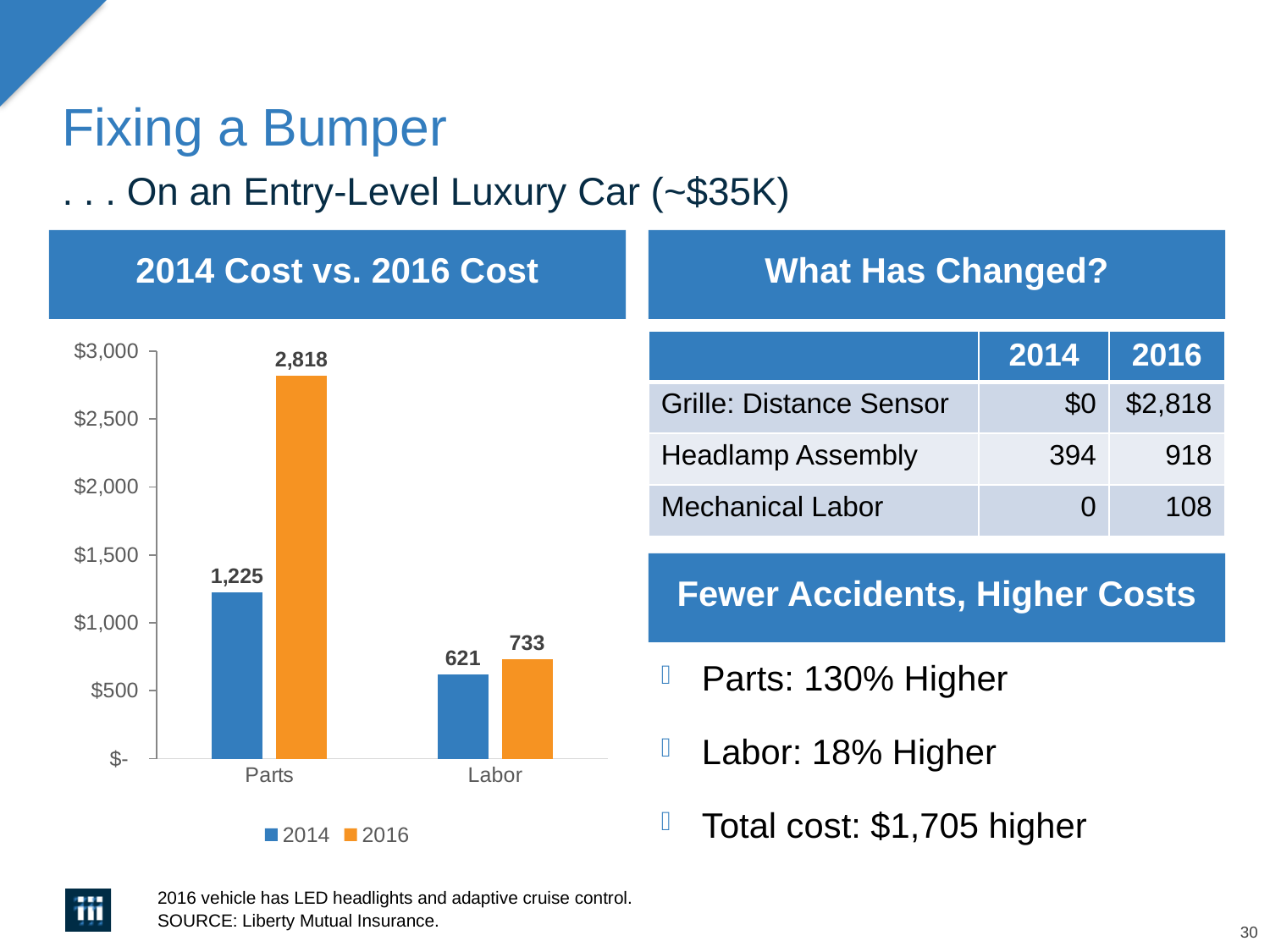
How many categories are shown on the x axis of the chart? 2 What is the difference between the 2016 and 2014 values for Parts? 1,593 Which is larger, the 2014 value for Parts or the 2016 value for Labor? 2014 value for Parts How many series does the chart legend list? 2 What is the 2016 value for Labor? 733 What is the 2014 value for Parts? 1,225 What is the difference between the 2016 and 2014 values for Labor? 112 What type of chart is shown on the slide? Bar chart What is the 2016 value for Parts? 2,818 What is the 2014 value for Labor? 621 Which bar in the chart has the lowest value? Labor, 2014 Which bar in the chart has the highest value? Parts, 2016